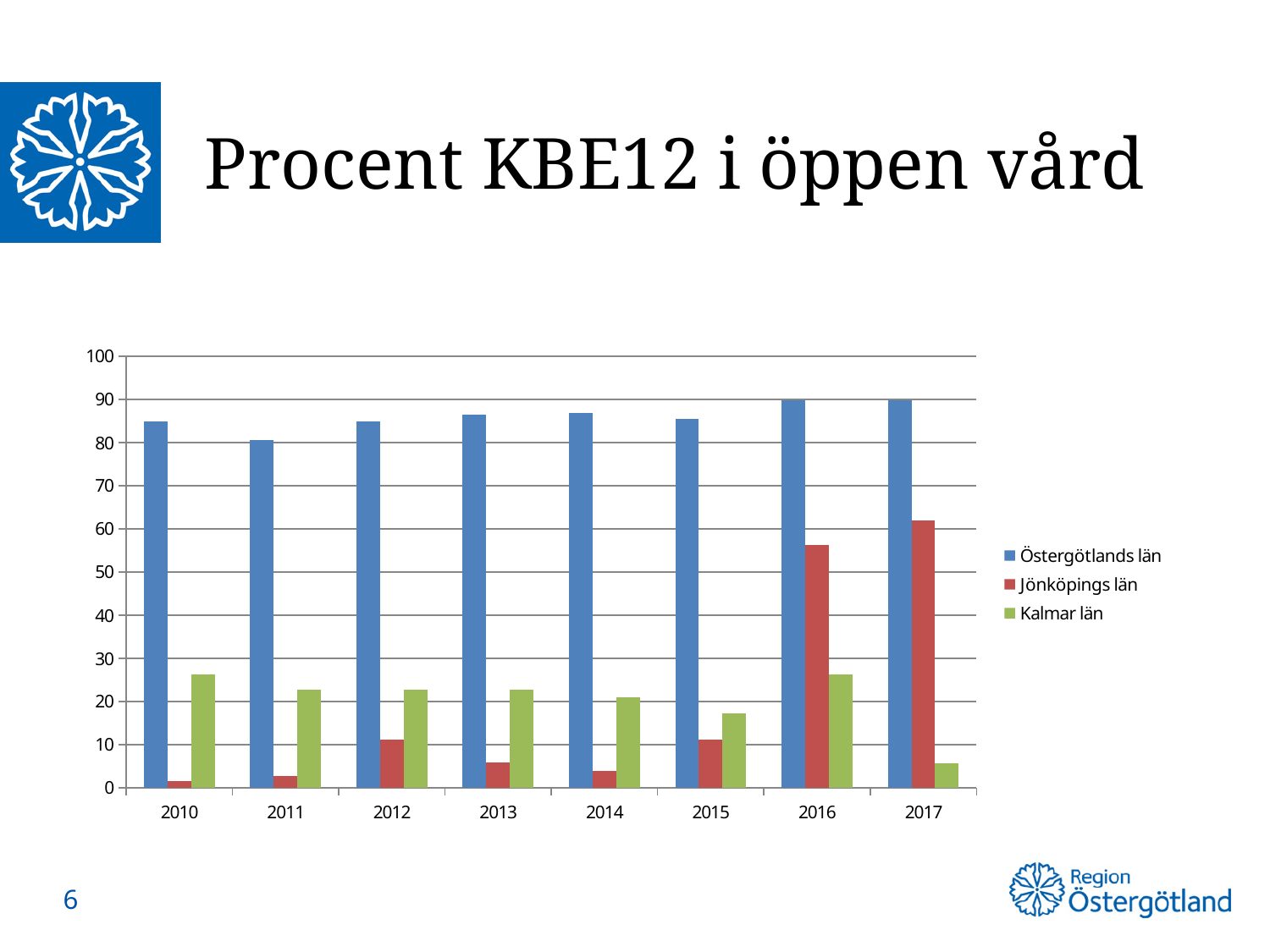
How many series does the legend list? 3 Which series is shown in green? Kalmar län Is the value for Kalmar län in 2017 greater or less than 10? less What kind of chart is shown on the slide? Bar chart How many years are shown on the x axis? 8 In which year is the value for Kalmar län lowest? 2017 What is the title of the slide? Procent KBE12 i öppen vård Is the value for Jönköpings län in 2017 greater or less than 50? greater Does the value for Jönköpings län rise or fall from 2015 to 2017? rise In which year is the value for Jönköpings län highest? 2017 In 2016, which is larger: the value for Jönköpings län or the value for Kalmar län? Jönköpings län Is the value for Östergötlands län in 2011 greater or less than 90? less